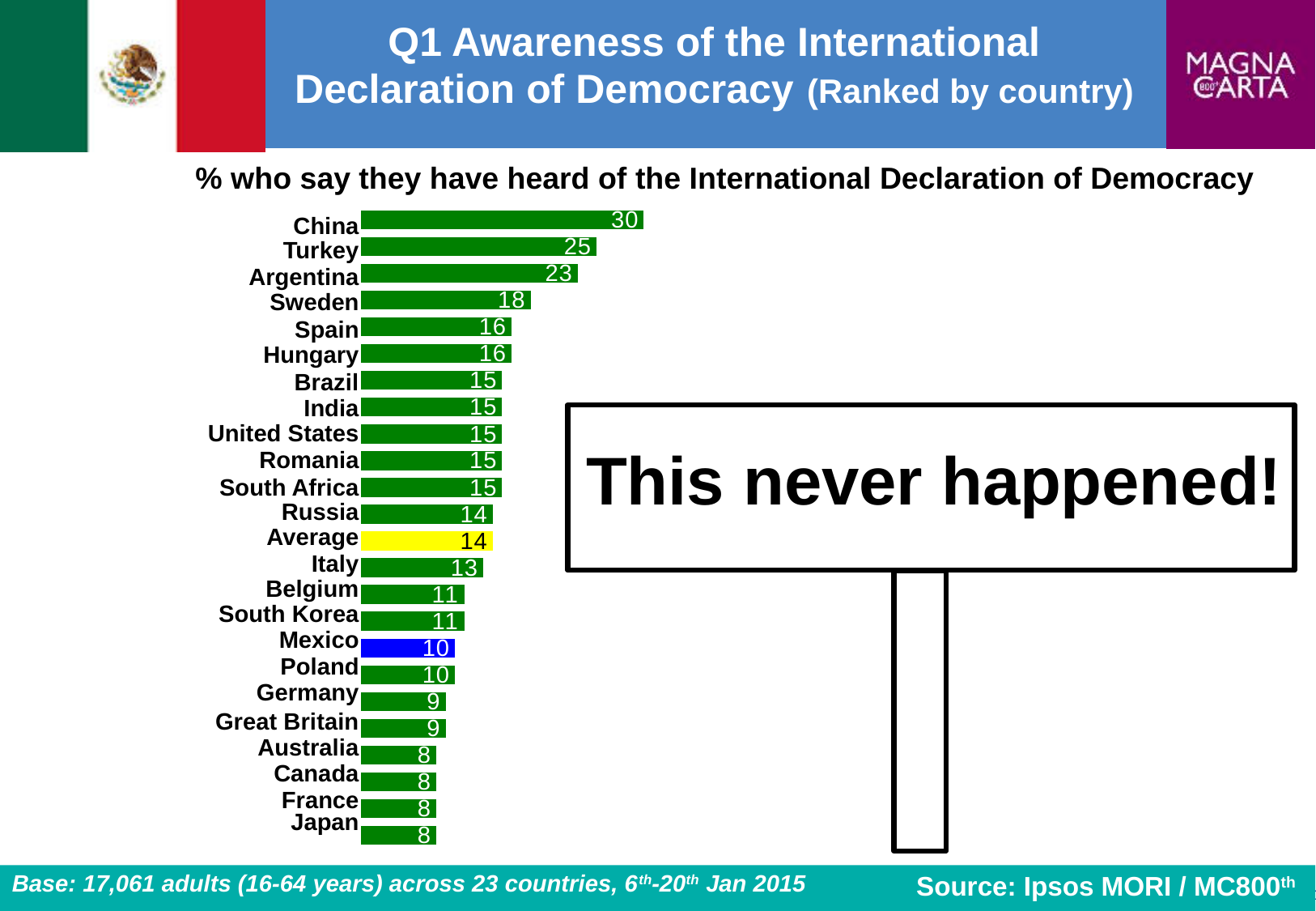
What type of chart is shown on the slide? Bar chart What is the Average value shown on the chart? 14 What is the value shown for Mexico? 10 What is the difference between the values for China and Turkey? 5 Which has a higher value, Russia or Poland? Russia What percentage of people in China say they have heard of the International Declaration of Democracy? 30 How much higher is Argentina's value than Mexico's? 13 Which country has the highest percentage who say they have heard of the International Declaration of Democracy? China How many bars are plotted on the chart, including the Average bar? 24 Which has a higher value, Italy or Belgium? Italy Which bar on the chart is coloured blue? Mexico What value is shown for Sweden? 18